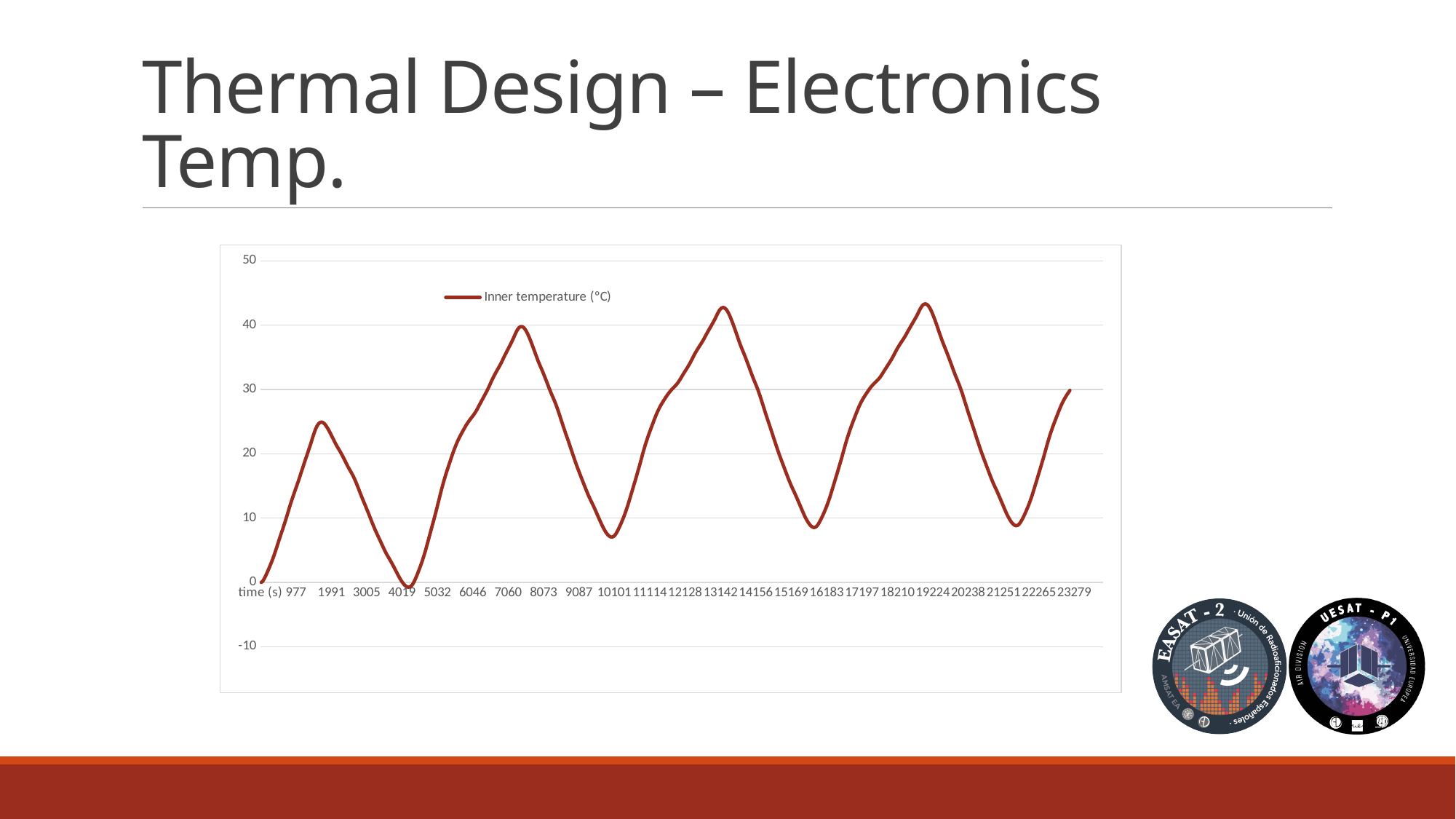
What kind of chart is shown on the slide? line chart Is the inner temperature at time 7060 greater or less than 30? greater Is the inner temperature at time 13142 greater or less than 40? greater Is the inner temperature at time 10101 greater or less than 10? less Does the inner temperature rise or fall between time 7060 and time 10101? fall What is the name of the series shown in the chart legend? Inner temperature (°C) How many series does the chart legend list? 1 What is the highest value shown on the vertical axis of the chart? 50